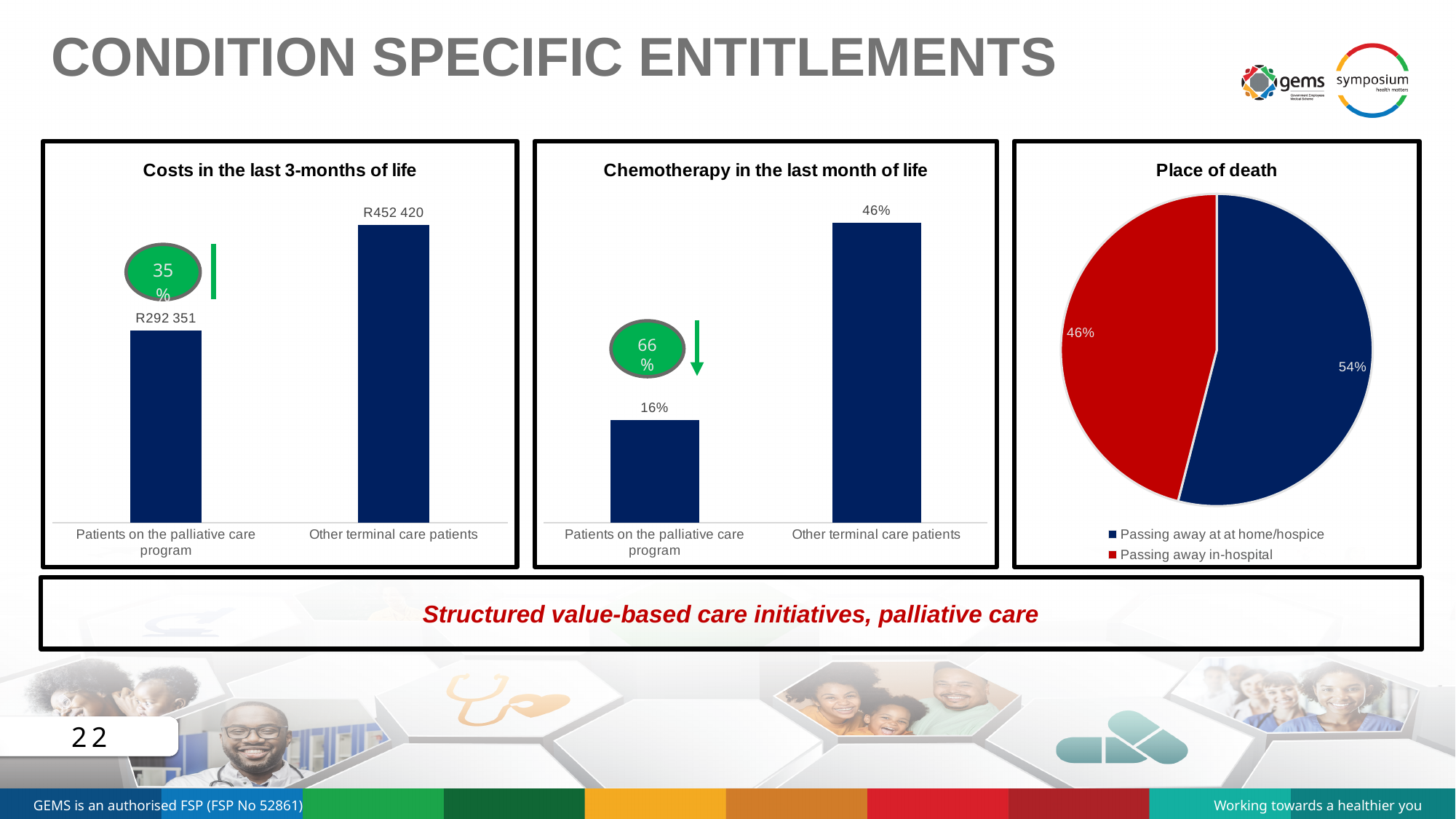
In the 'Costs in the last 3-months of life' chart, what is the value for Patients on the palliative care program? R292 351 How many categories are shown in the 'Costs in the last 3-months of life' chart? 2 In the 'Chemotherapy in the last month of life' chart, what is the value for Patients on the palliative care program? 16% In the 'Place of death' chart, what share is Passing away in-hospital? 46% In the 'Place of death' chart, what share is Passing away at at home/hospice? 54% In the 'Costs in the last 3-months of life' chart, what is the difference between the cost for Other terminal care patients and Patients on the palliative care program? R160 069 In the 'Chemotherapy in the last month of life' chart, what is the value for Other terminal care patients? 46% What kind of chart is the 'Place of death' chart? Pie chart In the 'Costs in the last 3-months of life' chart, which category has the higher cost? Other terminal care patients In the 'Chemotherapy in the last month of life' chart, what is the difference between the two bars? 30% In the 'Chemotherapy in the last month of life' chart, which category has the lower value? Patients on the palliative care program In the 'Costs in the last 3-months of life' chart, what is the value for Other terminal care patients? R452 420